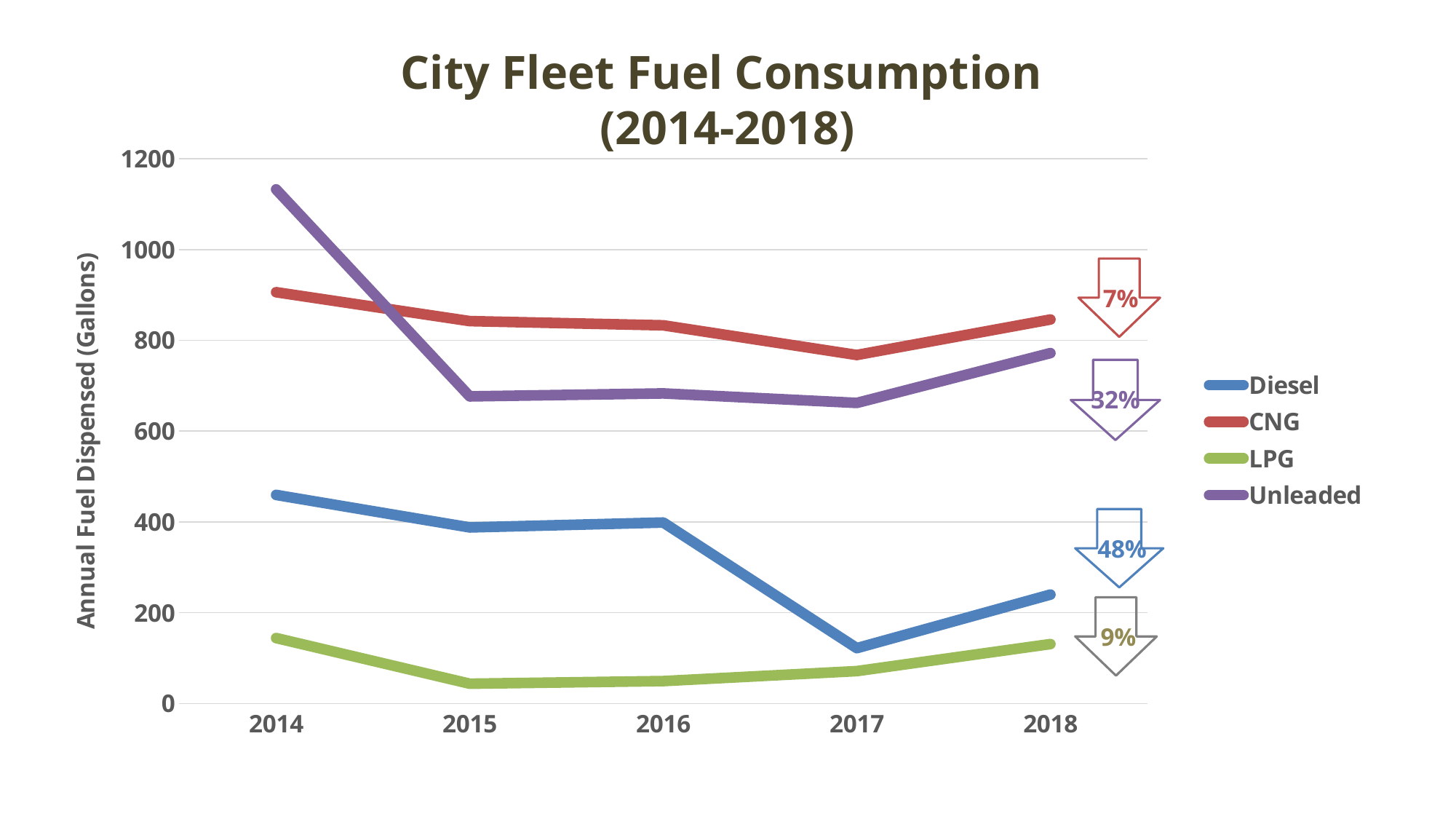
In 2015, which was larger: CNG or Unleaded? CNG What percentage is shown in the blue arrow next to the Diesel line? 48% Which fuel type had the highest consumption in 2014? Unleaded What kind of chart is shown on the slide? line chart Is the value for CNG in 2018 greater or less than 800? greater Which fuel type had the lowest consumption in 2018? LPG Is the value for Unleaded in 2014 greater or less than 1000? greater How many series does the legend list? 4 How many years are plotted along the x axis? 5 Did Unleaded consumption rise or fall from 2014 to 2015? fall Is the value for Diesel in 2017 greater or less than 200? less Which fuel type had the highest consumption in 2018? CNG